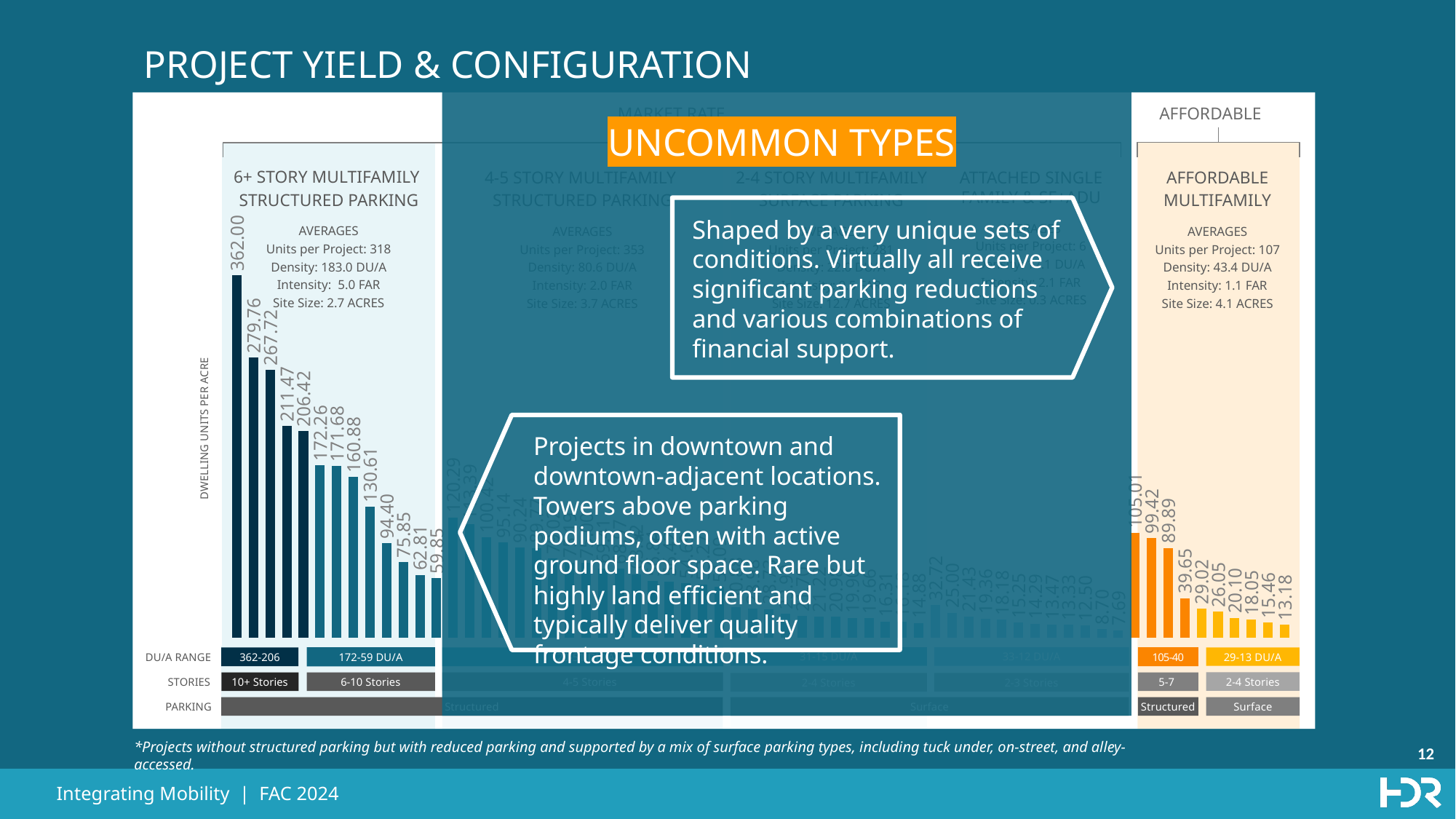
What is the highest dwelling units per acre value shown in the Affordable Multifamily group? 105.01 What is the lowest dwelling units per acre value shown in the Affordable Multifamily group? 13.18 Which is larger: the highest bar in the 6+ Story Multifamily Structured Parking group or the highest bar in the Affordable Multifamily group? 6+ Story Multifamily Structured Parking What DU/A range is shown for the first (dark) sub-group of the 6+ Story Multifamily Structured Parking bars? 362-206 What is the difference between the highest bar (362.00) and the second-highest bar (279.76) in the 6+ Story Multifamily Structured Parking group? 82.24 What is the label of the vertical axis of the chart? DWELLING UNITS PER ACRE How many bars are plotted in the Affordable Multifamily group? 10 How many bars are plotted in the 6+ Story Multifamily Structured Parking group? 13 Do the bar values rise or fall from left to right within the 6+ Story Multifamily Structured Parking group? fall What is the lowest dwelling units per acre value shown in the 6+ Story Multifamily Structured Parking group? 59.85 What kind of chart is shown on the slide? bar chart What is the highest dwelling units per acre value shown in the 6+ Story Multifamily Structured Parking group? 362.00